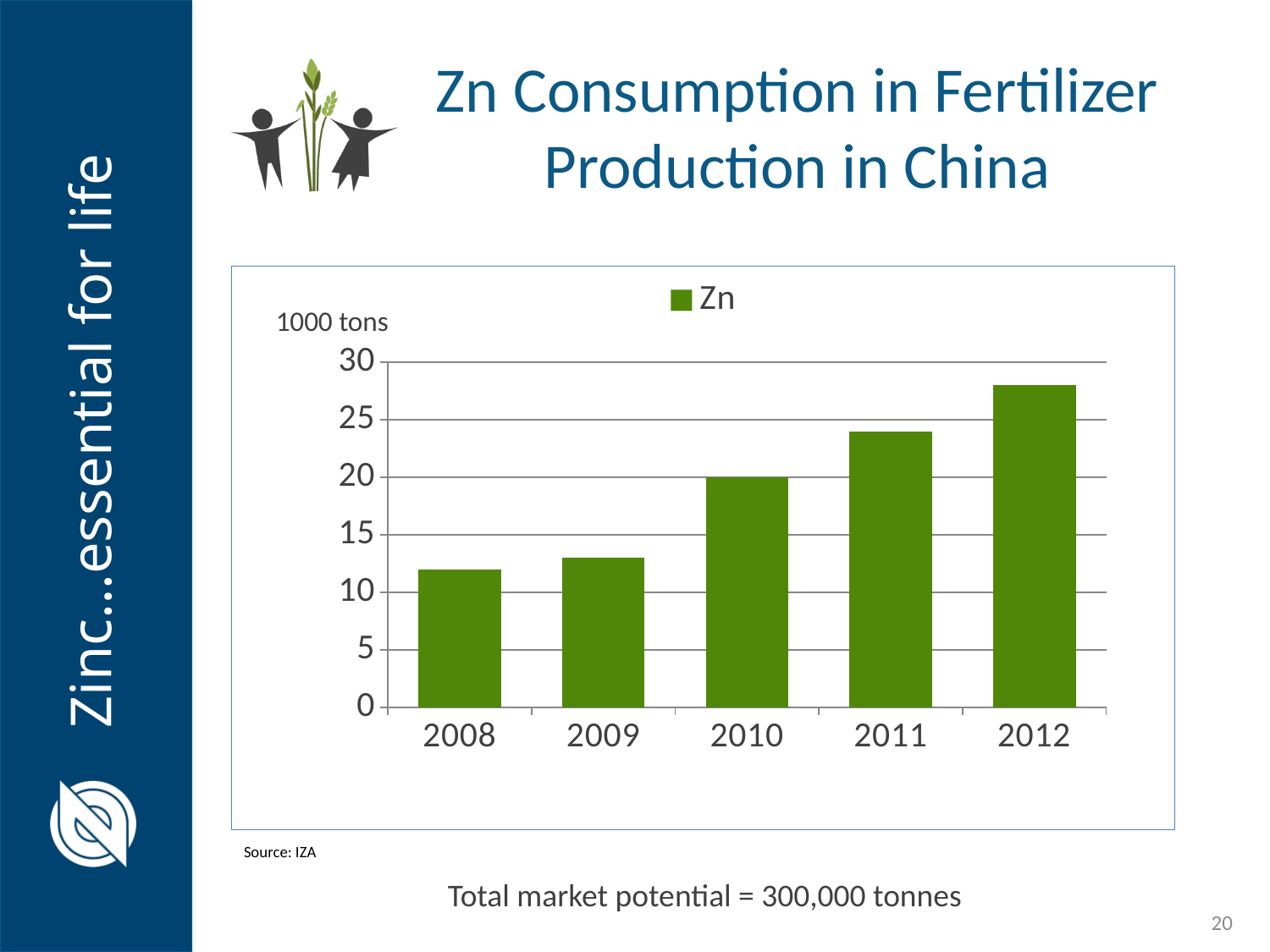
How many series does the chart legend list? 1 Which year has the highest Zn consumption in the chart? 2012 Is the value for 2011 greater or less than 20? greater Do the values rise or fall from 2008 to 2012 along the x axis? rise Is the value for 2008 greater or less than 15? less Which is larger, the value for 2009 or the value for 2011? 2011 Is the value for 2012 greater or less than 25? greater Which year has the lowest Zn consumption in the chart? 2008 What kind of chart is shown on the slide? bar chart How many years are shown on the x axis of the chart? 5 What unit is shown above the y axis of the chart? 1000 tons What is the Zn consumption value for 2010 in the chart? 20